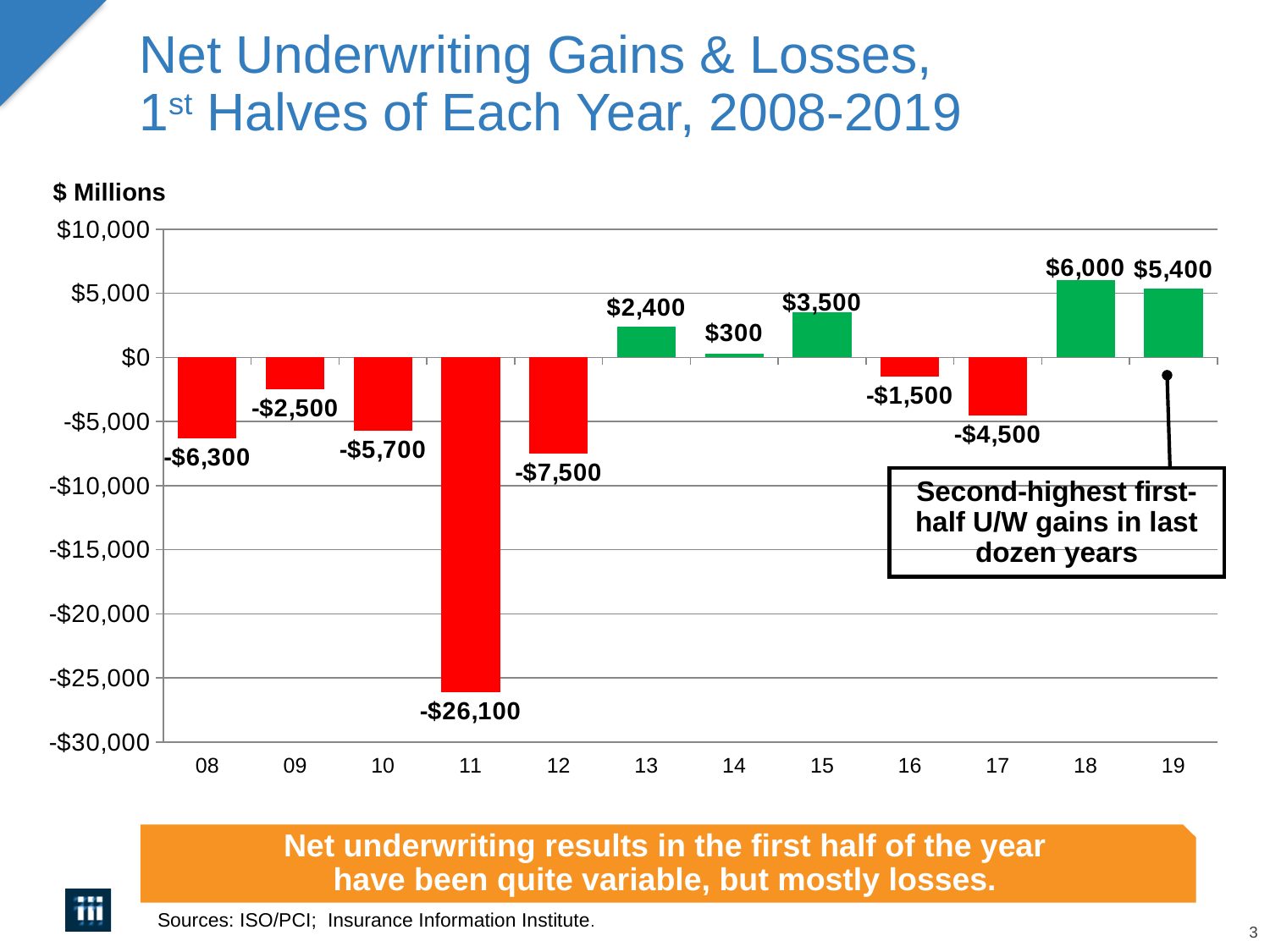
What is the net underwriting result for the first half of 2011? -$26,100 What colour are the bars for years with net underwriting losses? Red What unit is stated above the chart's y axis? $ Millions Which year has the highest first-half net underwriting gain? 18 How many years are shown on the x axis? 12 What is the net underwriting gain for the first half of 2018? $6,000 Which is larger, the value for 2013 or the value for 2015? 2015 What is the difference between the 2008 value and the 2009 value? $3,800 What is the difference between the 2018 value and the 2019 value? $600 What kind of chart is shown on the slide? Bar chart What is the value shown for 2014? $300 Which year has the lowest first-half net underwriting result? 11